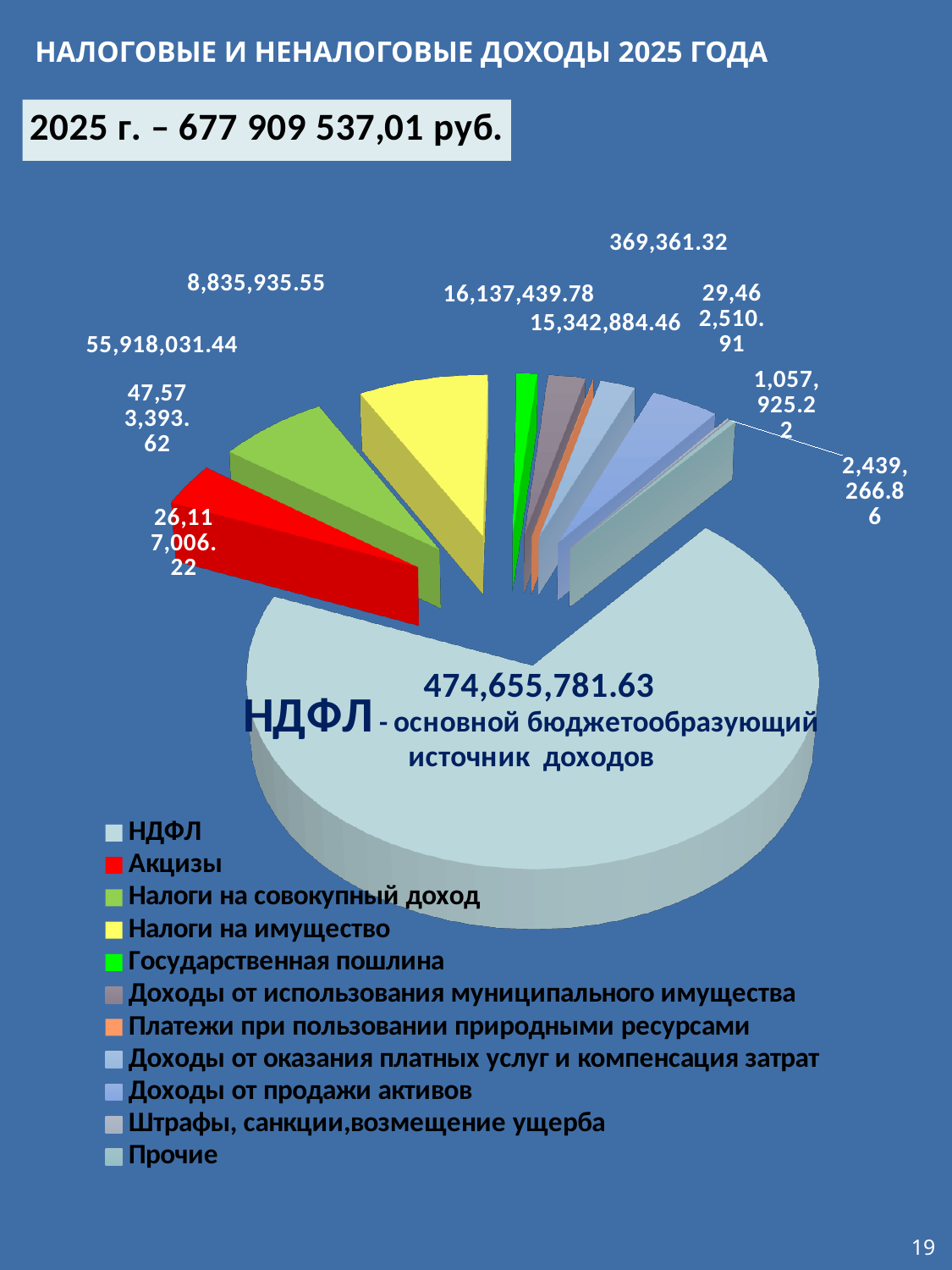
What is the value shown for Акцизы (the red slice)? 26,117,006.22 What kind of chart is shown on the slide? pie chart What is the value shown for НДФЛ? 474,655,781.63 How many slices does the pie chart have? 11 Which category has the largest slice of the pie? НДФЛ What is the title of the slide? НАЛОГОВЫЕ И НЕНАЛОГОВЫЕ ДОХОДЫ 2025 ГОДА Which is larger, НДФЛ or Акцизы? НДФЛ What is the difference between the values for НДФЛ and Акцизы? 448,538,775.41 What colour is the Акцизы slice? red How many categories does the legend list? 11 What total amount for 2025 is shown on the slide? 677 909 537,01 руб. Is the value for НДФЛ greater or less than 400,000,000? greater